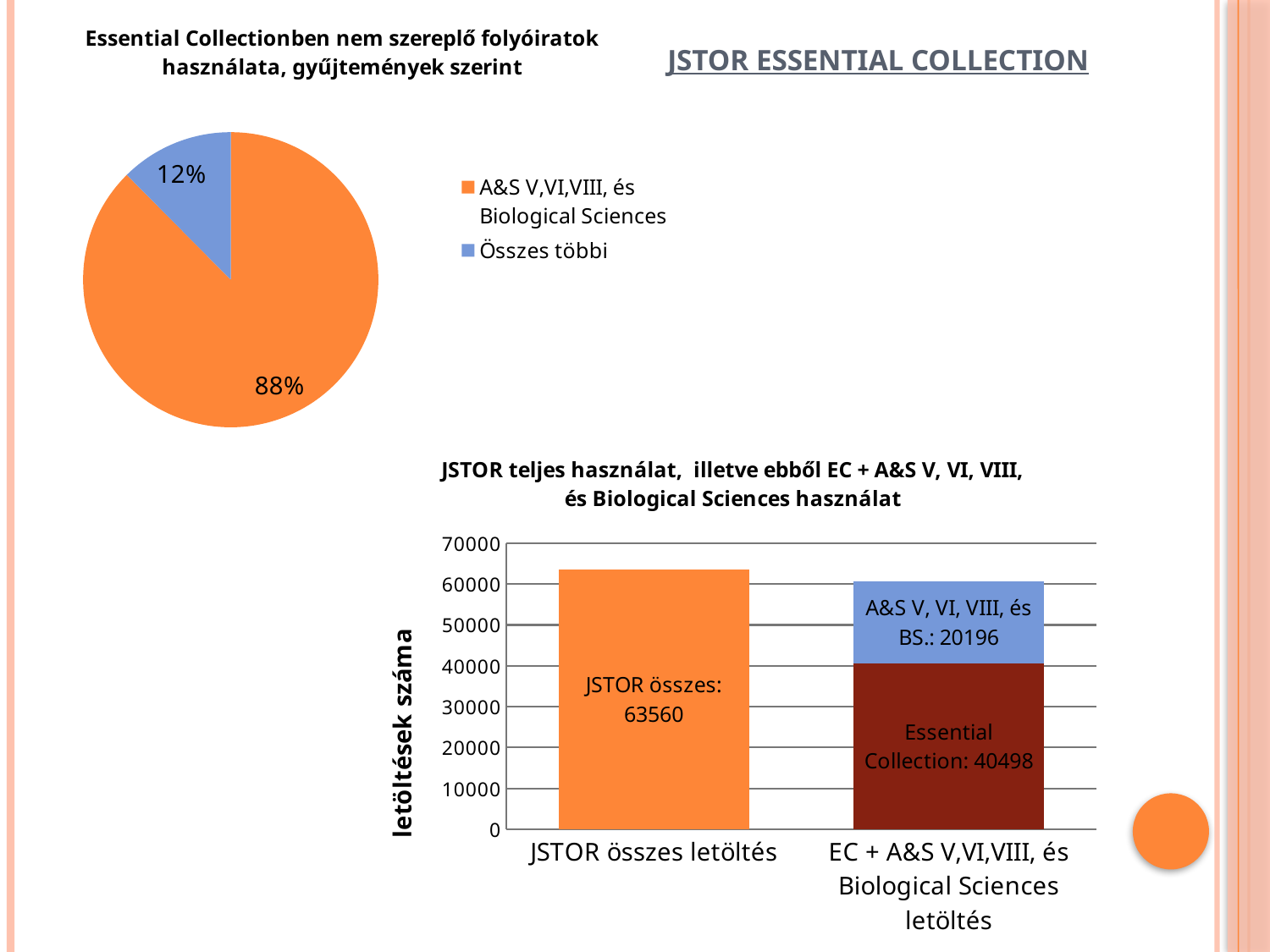
In the pie chart at the top left, what share does the 'Összes többi' slice have? 12% In the bar chart at the bottom right, what is the value of the 'Essential Collection' segment? 40498 In the bar chart at the bottom right, what is the difference between the 'Essential Collection' segment and the 'A&S V, VI, VIII, és BS.' segment? 20302 What kind of chart is the chart at the top left of the slide? Pie chart In the pie chart at the top left, which slice is the largest? A&S V,VI,VIII, és Biological Sciences In the bar chart at the bottom right, what is the value of the 'A&S V, VI, VIII, és BS.' segment? 20196 In the bar chart at the bottom right, what is the value labelled 'JSTOR összes'? 63560 How many slices does the pie chart at the top left have? 2 In the bar chart at the bottom right, what is the label of the vertical axis? letöltések száma What kind of chart is the chart at the bottom right of the slide? Bar chart In the pie chart at the top left, what share does the 'A&S V,VI,VIII, és Biological Sciences' slice have? 88% In the bar chart at the bottom right, what is the total of the stacked bar for 'EC + A&S V,VI,VIII, és Biological Sciences letöltés'? 60694